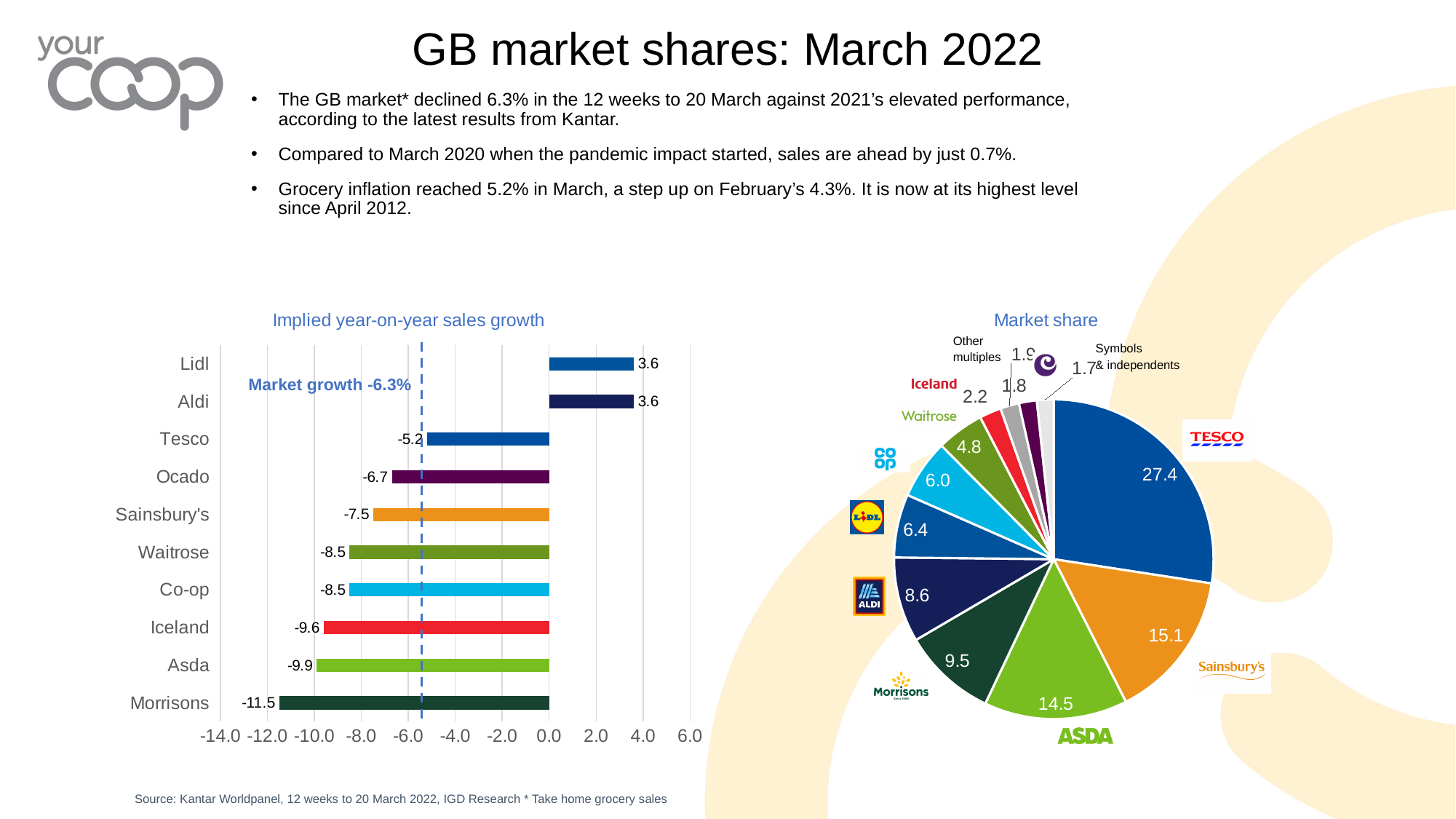
In the 'Implied year-on-year sales growth' chart, which retailer has the lowest value? Morrisons In the 'Market share' chart, what is the difference between the shares of Sainsbury's and Asda? 0.6 In the 'Market share' chart, which retailer has the largest share? Tesco In the 'Implied year-on-year sales growth' chart, what is the value for Morrisons? -11.5 How many retailers are shown in the 'Implied year-on-year sales growth' chart? 10 In the 'Market share' chart, what is the share for Waitrose? 4.8 What market growth figure is annotated on the 'Implied year-on-year sales growth' chart? -6.3% In the 'Implied year-on-year sales growth' chart, what is the value for Tesco? -5.2 In the 'Market share' chart, what is the share for Tesco? 27.4 In the 'Implied year-on-year sales growth' chart, what is the difference between the values for Ocado and Sainsbury's? 0.8 In the 'Implied year-on-year sales growth' chart, which is larger, the value for Iceland or the value for Asda? Iceland What kind of chart is the 'Implied year-on-year sales growth' chart? Bar chart